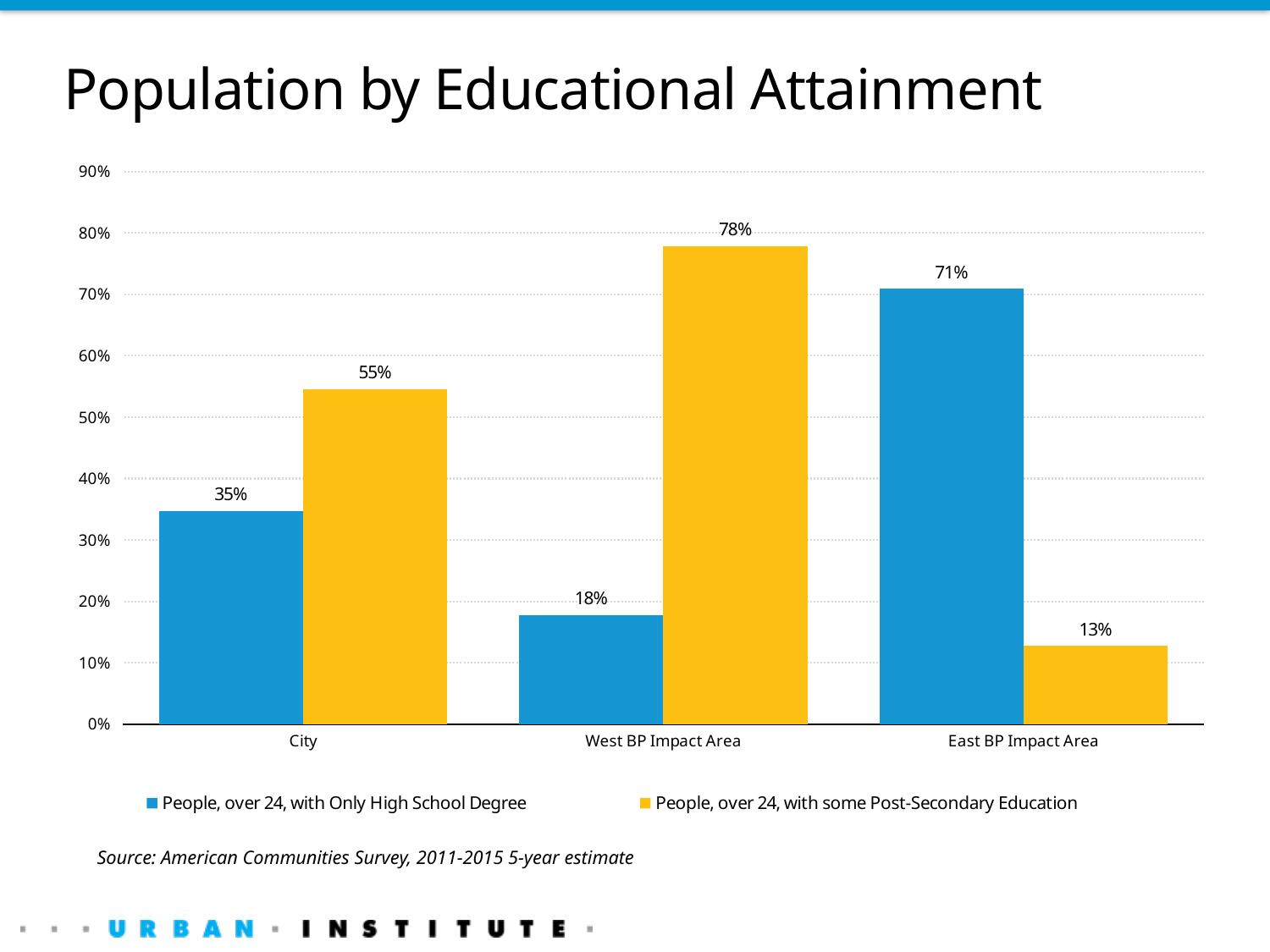
How many areas are shown on the x axis? 3 Which area has the lowest share of people over 24 with only a high school degree? West BP Impact Area What percentage of people over 24 in the East BP Impact Area have only a high school degree? 71% What kind of chart is shown on the slide? Bar chart What is the difference between the share with some post-secondary education and the share with only a high school degree in the City? 20% What percentage of people over 24 in the City have only a high school degree? 35% What colour represents people over 24 with some post-secondary education? Yellow How many series does the legend list? 2 What is the title of the chart? Population by Educational Attainment In the East BP Impact Area, which is larger: the share with only a high school degree or the share with some post-secondary education? Only High School Degree What percentage of people over 24 in the West BP Impact Area have some post-secondary education? 78% Which area has the highest share of people over 24 with some post-secondary education? West BP Impact Area